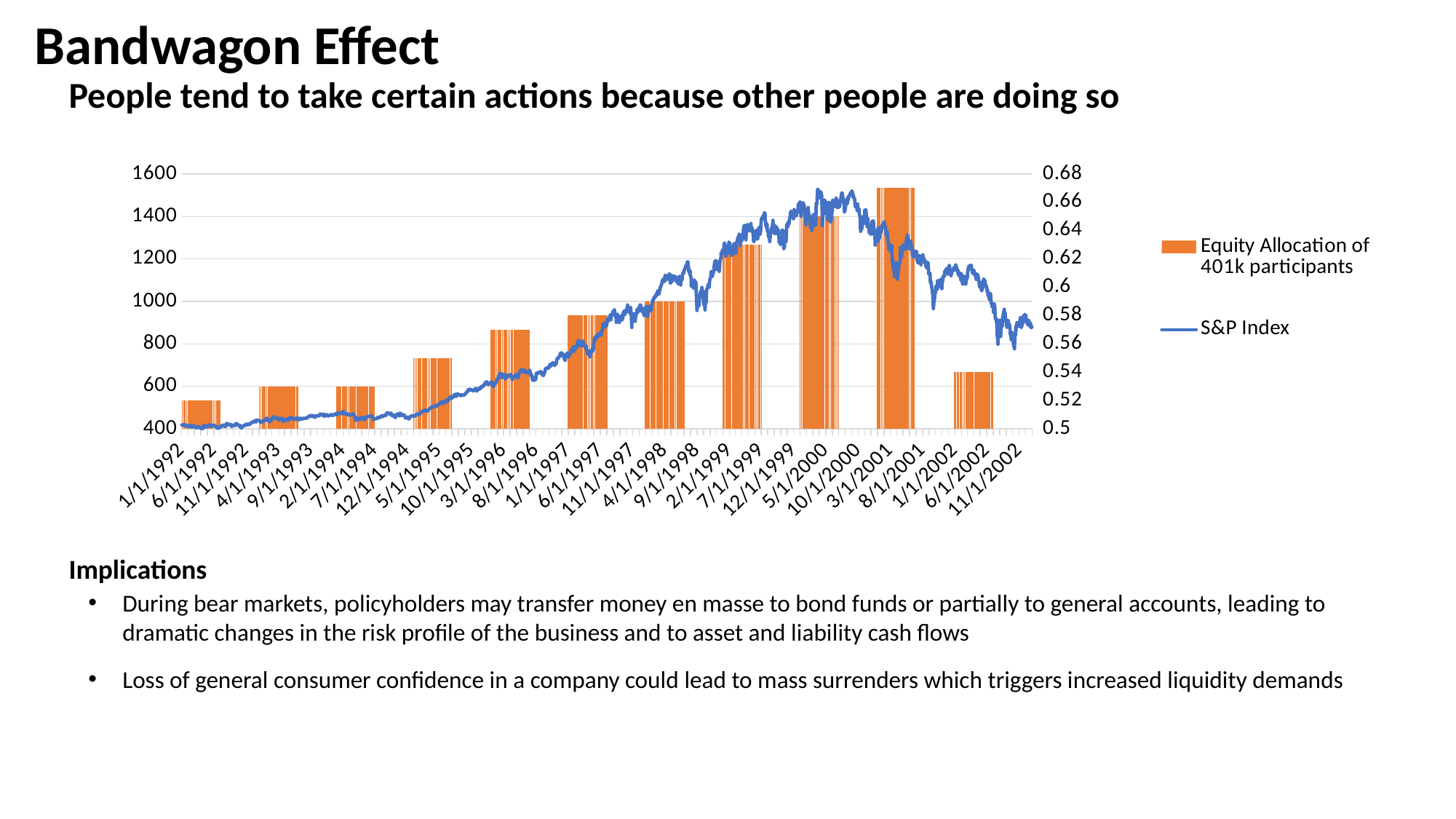
What are the two series named in the chart's legend? Equity Allocation of 401k participants; S&P Index How many series does the chart's legend list? 2 Is the S&P Index value at 1/1/1992 greater or less than 600? less What kind of chart is shown on the slide? A combination bar and line chart Which is larger, the Equity Allocation of 401k participants bar in 2001 or the bar in 2002? 2001 In which year is the Equity Allocation of 401k participants bar the lowest? 1992 Does the S&P Index generally rise or fall from mid-2000 to 11/1/2002? fall Does the S&P Index generally rise or fall from 1/1/1992 to early 2000? rise Is the Equity Allocation of 401k participants bar at 1/1/1992 greater or less than 0.54? less In which year does the Equity Allocation of 401k participants reach its highest bar? 2001 Is the Equity Allocation of 401k participants bar around 3/1/2001 greater or less than 0.64? greater Which series is drawn as bars in the chart? Equity Allocation of 401k participants